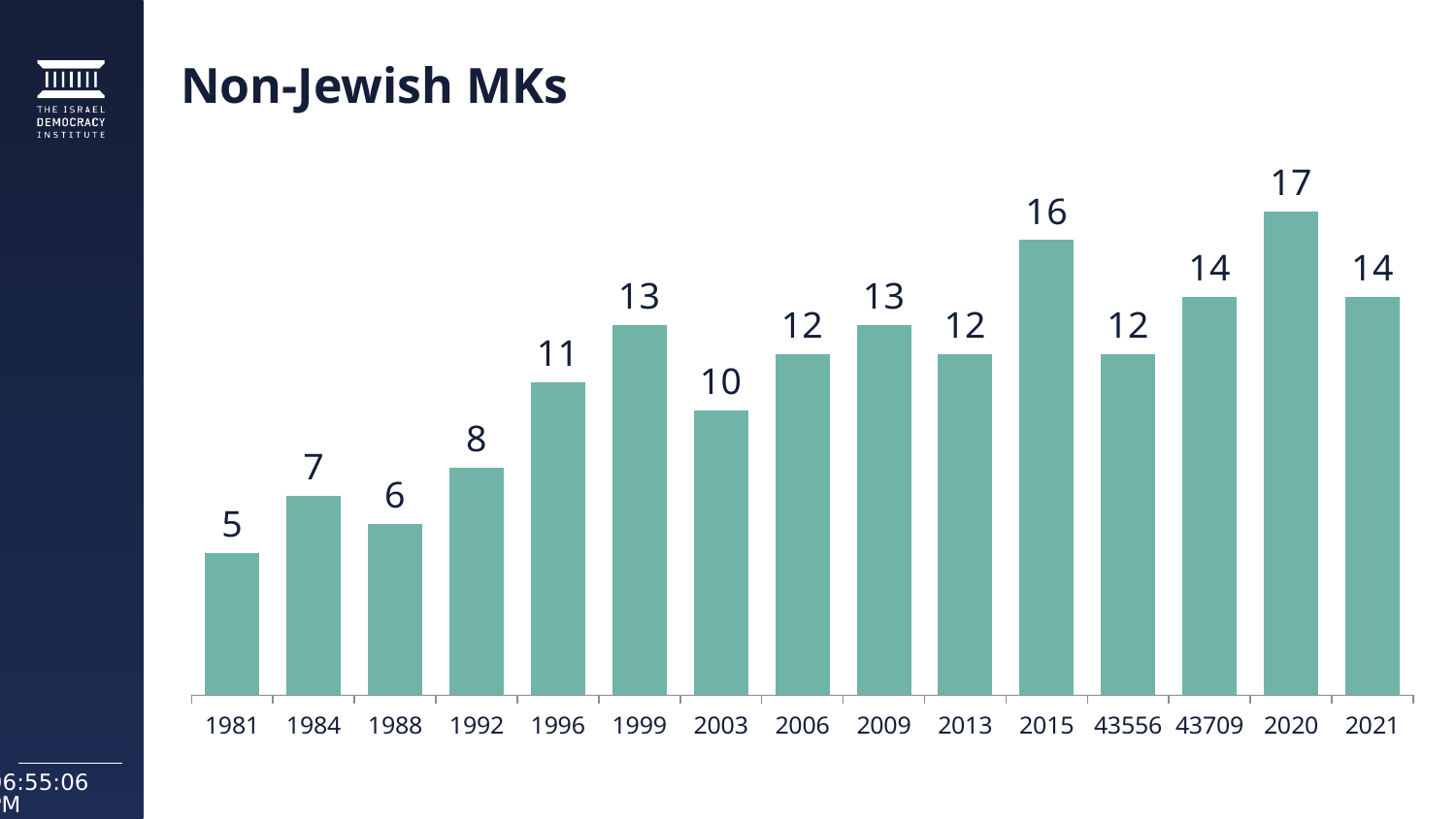
What is the value for 1981? 5 What is the value for 2003? 10 What kind of chart is shown on the slide? bar chart Which category has the highest value? 2020 How many categories are shown on the x axis? 15 Which category has the lowest value? 1981 What is the difference between the values for 2015 and 2013? 4 What is the title of the chart? Non-Jewish MKs What is the difference between the values for 2020 and 1981? 12 Which is larger, the value for 1996 or the value for 2003? 1996 What is the value for 2015? 16 Do the values generally rise or fall from 1981 to 1999? rise